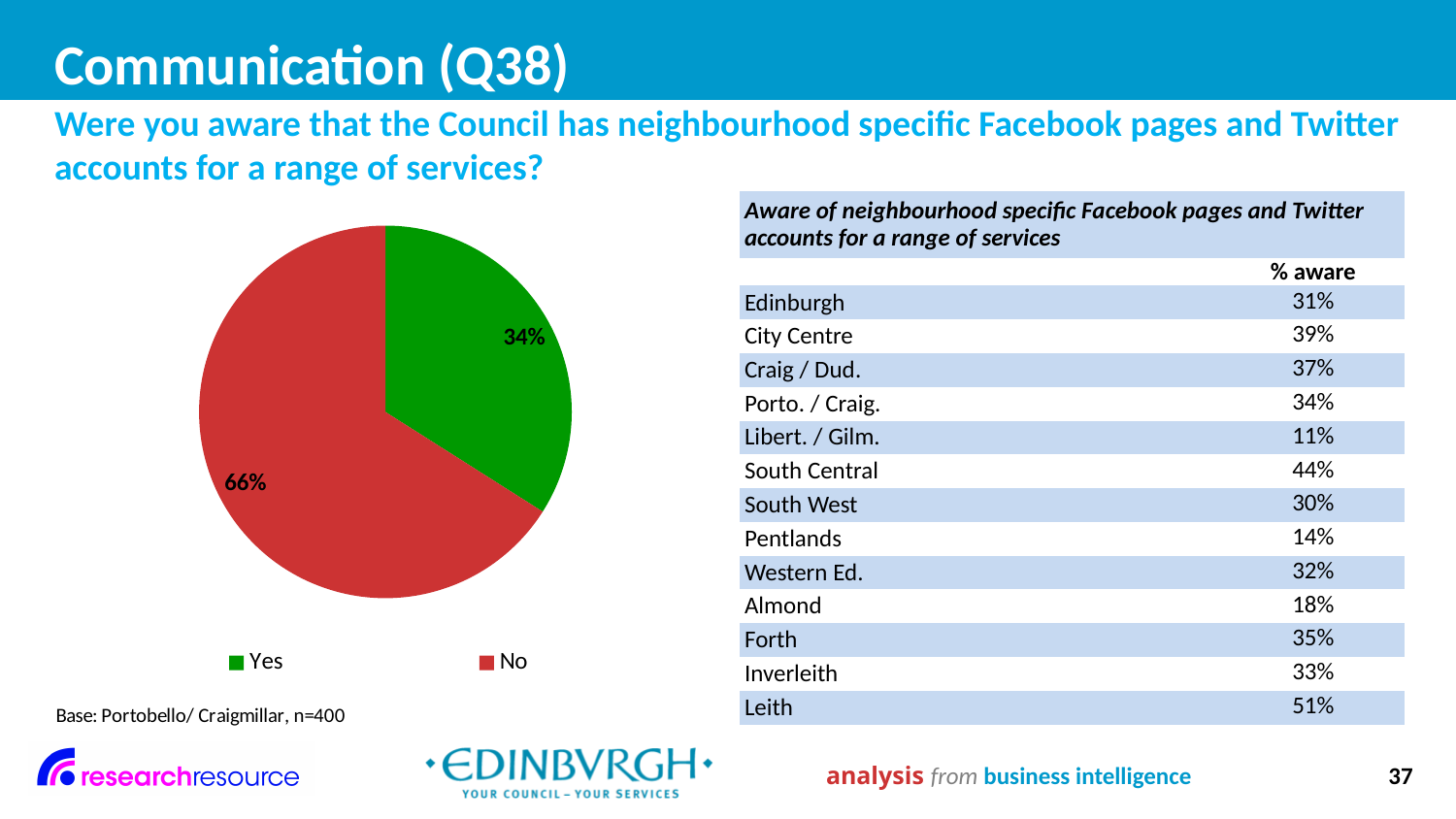
What percentage of respondents answered No in the pie chart? 66% How many entries does the pie chart legend list? 2 Which slice of the pie chart is the smallest? Yes Which is larger in the pie chart, the Yes slice or the No slice? No What kind of chart is shown on the slide? Pie chart How many slices does the pie chart have? 2 Is the Yes slice of the pie chart greater or less than 50%? less What colour is the Yes slice in the pie chart? Green What percentage of respondents answered Yes in the pie chart? 34% What colour is the No slice in the pie chart? Red What is the difference in percentage points between the No and Yes slices of the pie chart? 32 Which slice of the pie chart is the largest? No